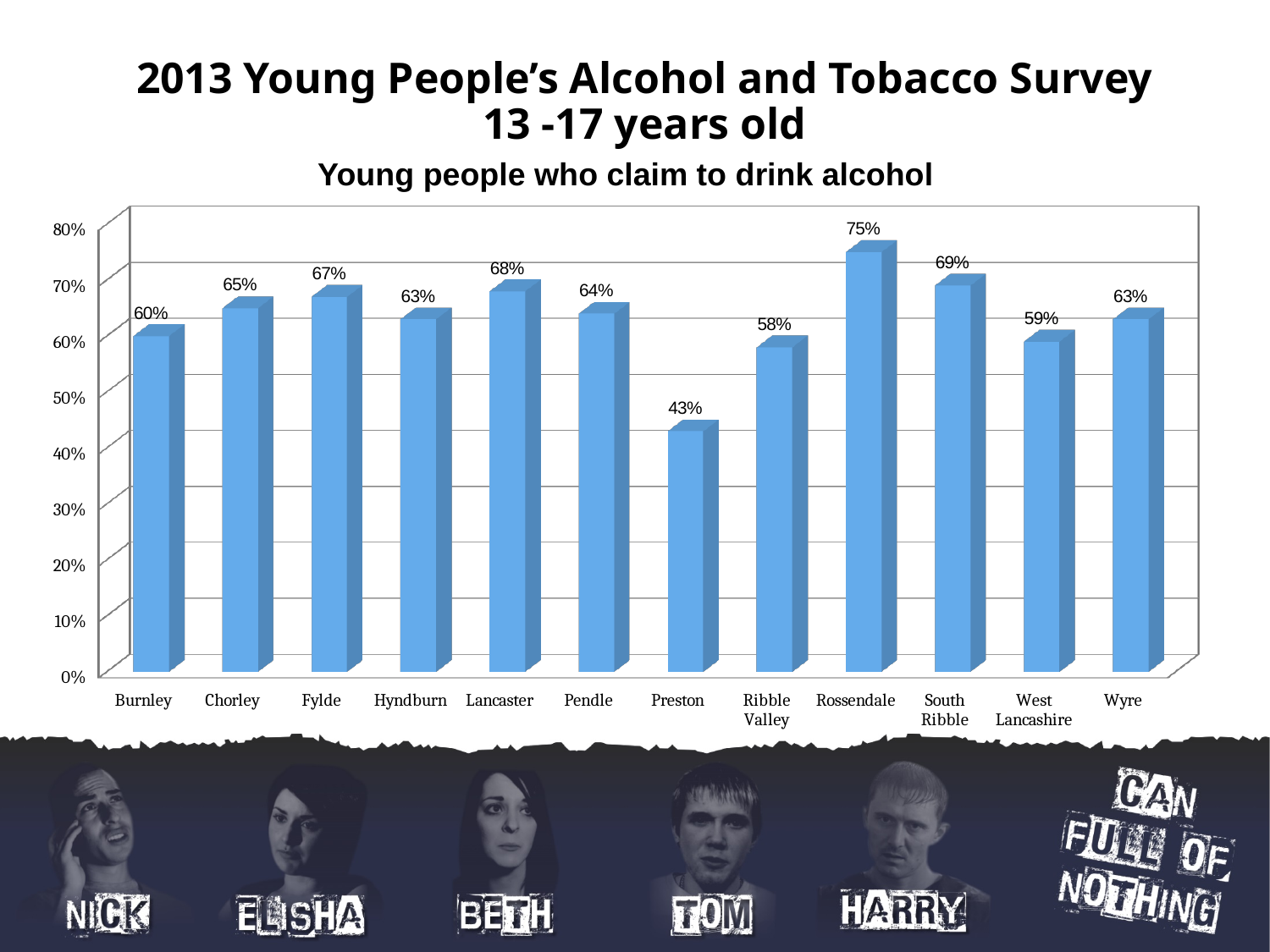
Which area has the highest percentage of young people who claim to drink alcohol? Rossendale What percentage of young people in Preston claim to drink alcohol? 43% Is the value for Chorley greater or less than 60%? greater What is the difference between the values for South Ribble and Ribble Valley? 11% What is the value shown for Rossendale? 75% How many areas are shown on the chart? 12 What is the value shown for West Lancashire? 59% Which area has the lowest percentage of young people who claim to drink alcohol? Preston What is the title of the chart? Young people who claim to drink alcohol Which has a higher value, Lancaster or Pendle? Lancaster What type of chart is shown on the slide? Bar chart What is the difference between the values for Rossendale and Preston? 32%